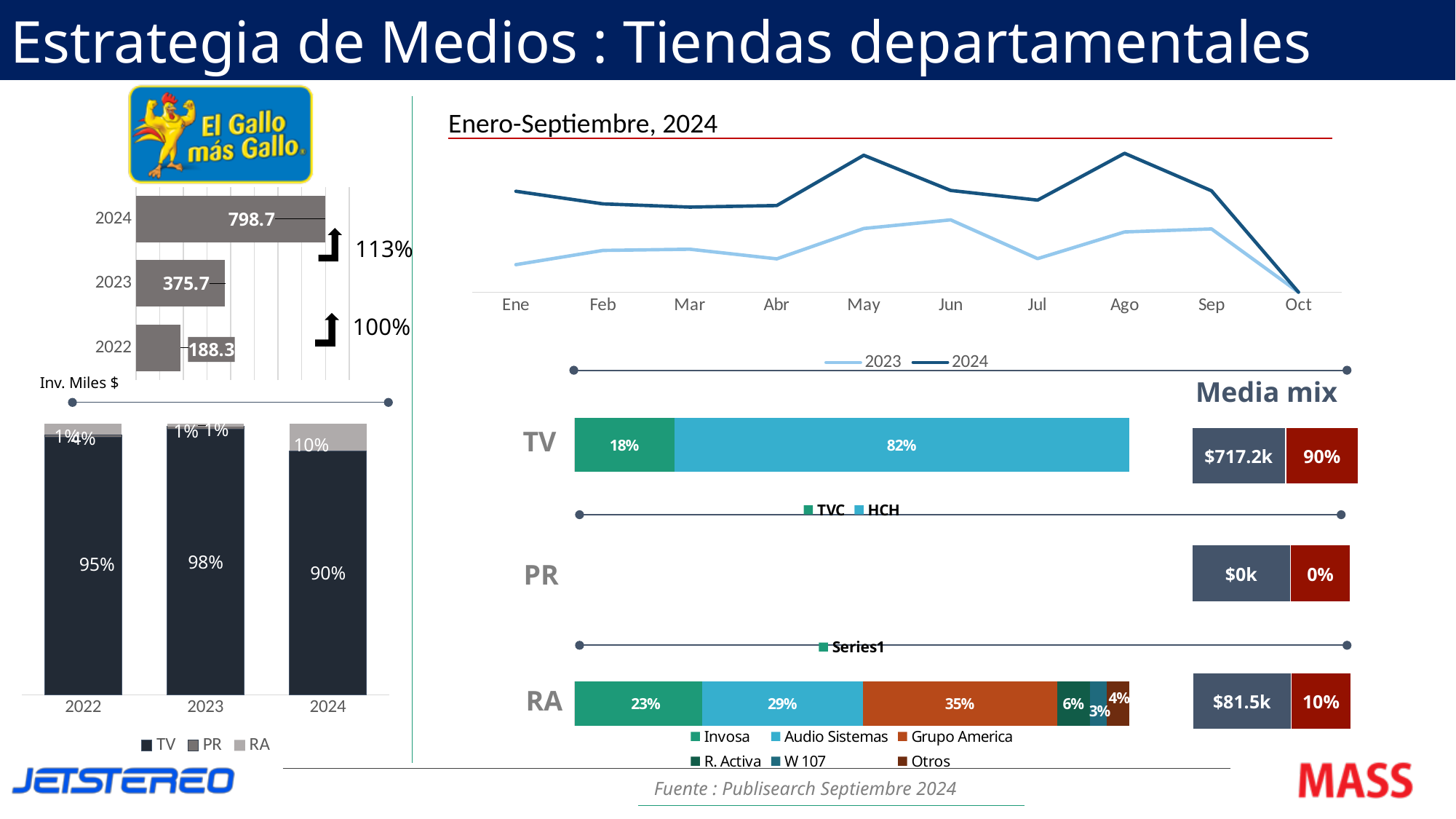
In the RA stacked bar at the bottom of the slide, which station has the largest share? Grupo America In the investment bar chart at the top left (Inv. Miles $), what is the value for 2022? 188.3 In the investment bar chart at the top left (Inv. Miles $), what is the value for 2024? 798.7 In the investment bar chart at the top left, what is the difference between the 2024 and 2023 values? 423.0 In the line chart titled 'Enero-Septiembre, 2024', which series is higher in May, 2023 or 2024? 2024 In the investment bar chart at the top left, which year has the lowest investment? 2022 In the line chart titled 'Enero-Septiembre, 2024', how many months are shown on the x axis? 10 In the stacked bar chart at the bottom left, what is the TV share for 2023? 98% How many series does the legend of the stacked bar chart at the bottom left list? 3 In the TV stacked bar in the middle of the slide, what is the share for HCH? 82% In the stacked bar chart at the bottom left, what is the RA share for 2024? 10% In the Media mix boxes on the right, what is the investment amount shown for RA? $81.5k